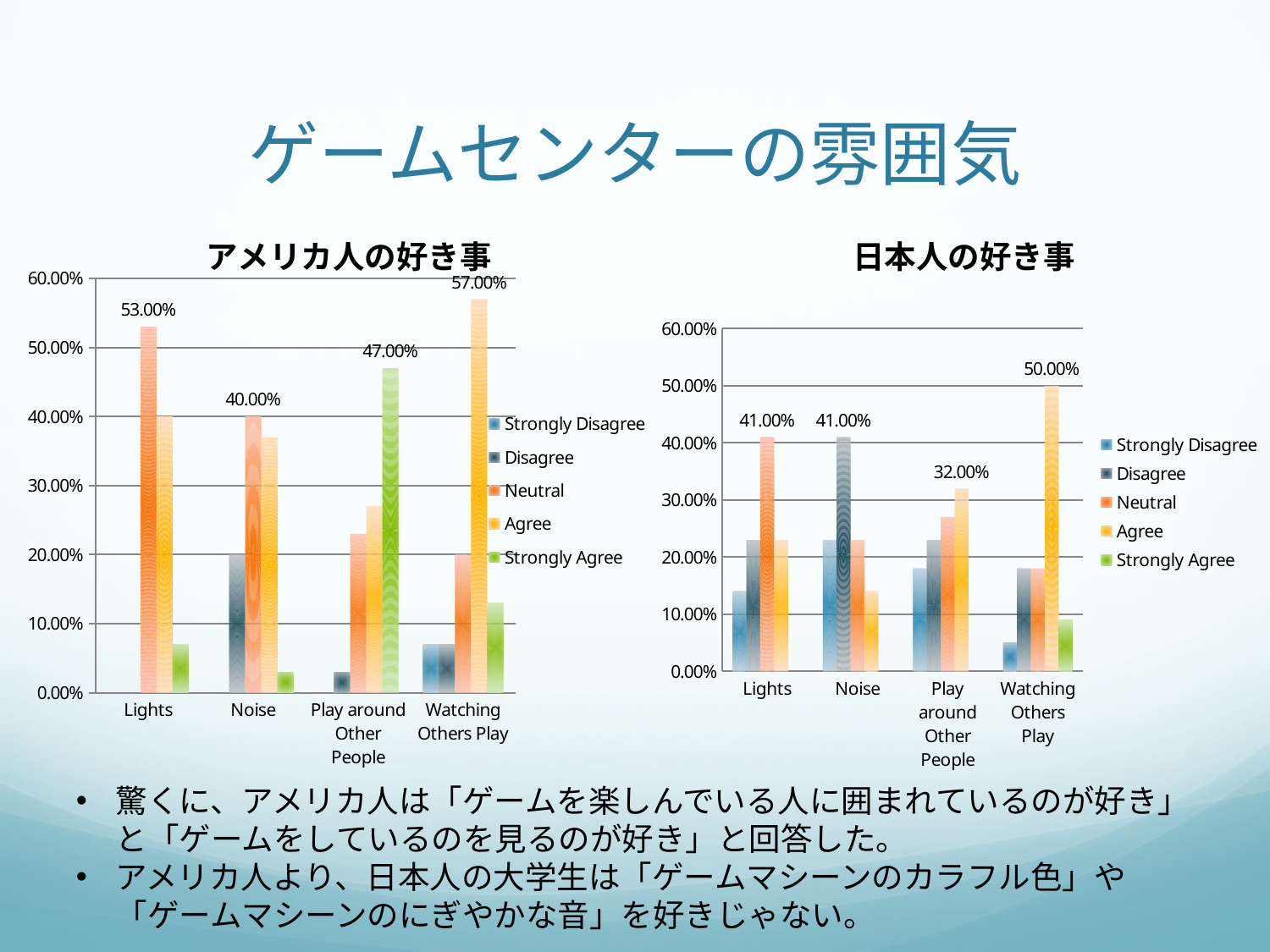
In the アメリカ人の好き事 chart, which is larger: the Neutral value for Lights or the Neutral value for Noise? Lights In the アメリカ人の好き事 chart, what is the Strongly Agree value for Play around Other People? 47.00% In the 日本人の好き事 chart, what is the Agree value for Play around Other People? 32.00% How many series does the legend of the 日本人の好き事 chart list? 5 In the アメリカ人の好き事 chart, is the Strongly Agree value for Lights greater or less than 10.00%? less In the アメリカ人の好き事 chart, what is the Neutral value for Lights? 53.00% In the 日本人の好き事 chart, what is the Disagree value for Noise? 41.00% How many categories are shown on the x axis of the アメリカ人の好き事 chart? 4 In the 日本人の好き事 chart, what is the Agree value for Watching Others Play? 50.00% In the 日本人の好き事 chart, which category has the highest Agree value? Watching Others Play In the アメリカ人の好き事 chart, what is the Agree value for Watching Others Play? 57.00% In the アメリカ人の好き事 chart, what is the difference between the Agree value for Watching Others Play and the Neutral value for Lights? 4.00%